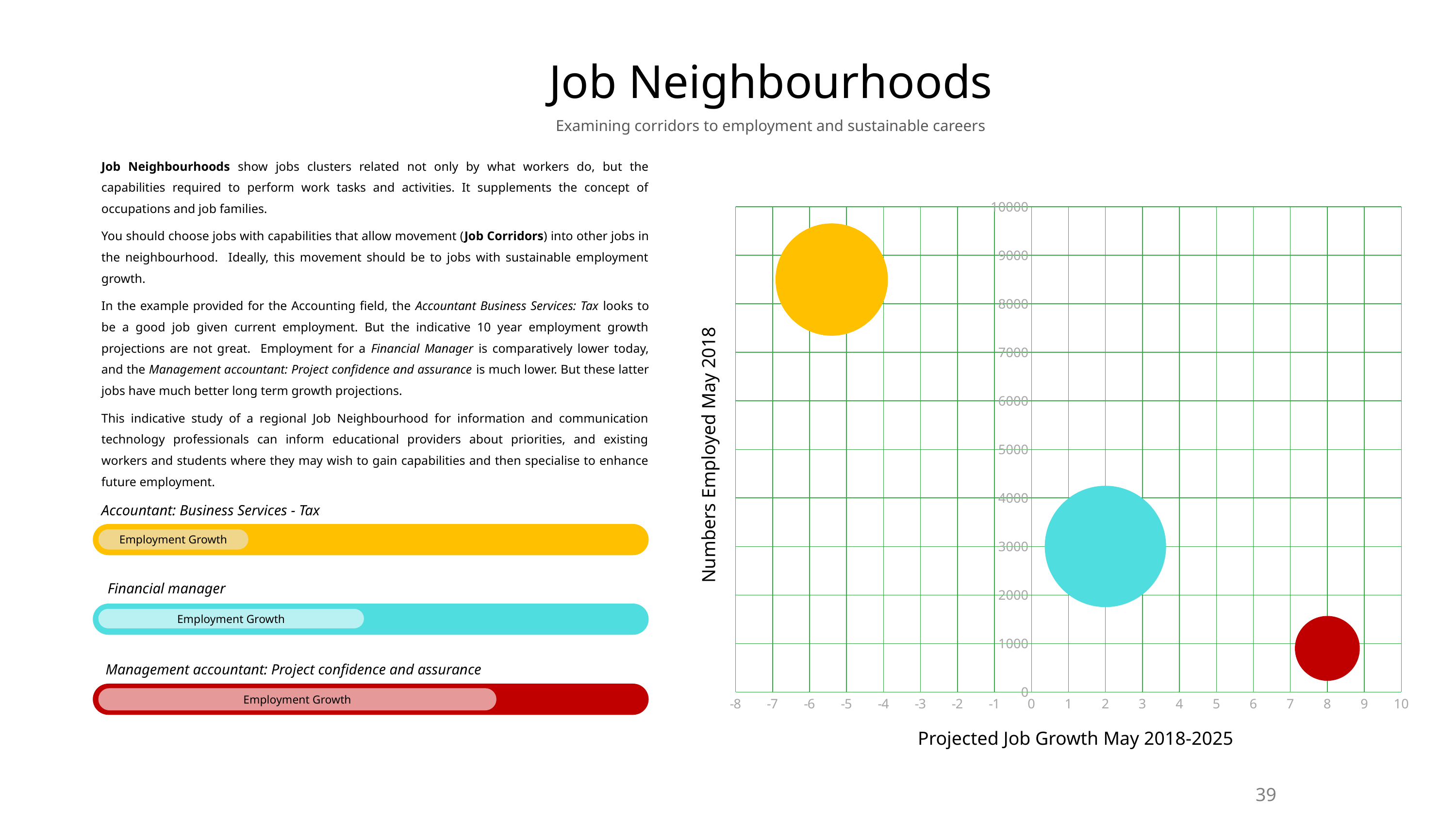
Is the Projected Job Growth value for the yellow bubble greater or less than 0? less Is the Numbers Employed May 2018 value for the yellow bubble greater or less than 7000? greater Is the Projected Job Growth value for the red bubble greater or less than 5? greater How many bubbles are plotted on the chart? 3 Which bubble has the highest Projected Job Growth May 2018-2025? the red bubble (Management accountant: Project confidence and assurance) What kind of chart is shown on the right of the slide? bubble chart Which has the larger Numbers Employed May 2018 value, the cyan bubble or the red bubble? the cyan bubble Which bubble has the highest value for Numbers Employed May 2018? the yellow bubble (Accountant: Business Services - Tax) What is the label of the horizontal axis of the chart? Projected Job Growth May 2018-2025 Which bubble has the lowest value for Numbers Employed May 2018? the red bubble (Management accountant: Project confidence and assurance) What is the label of the vertical axis of the chart? Numbers Employed May 2018